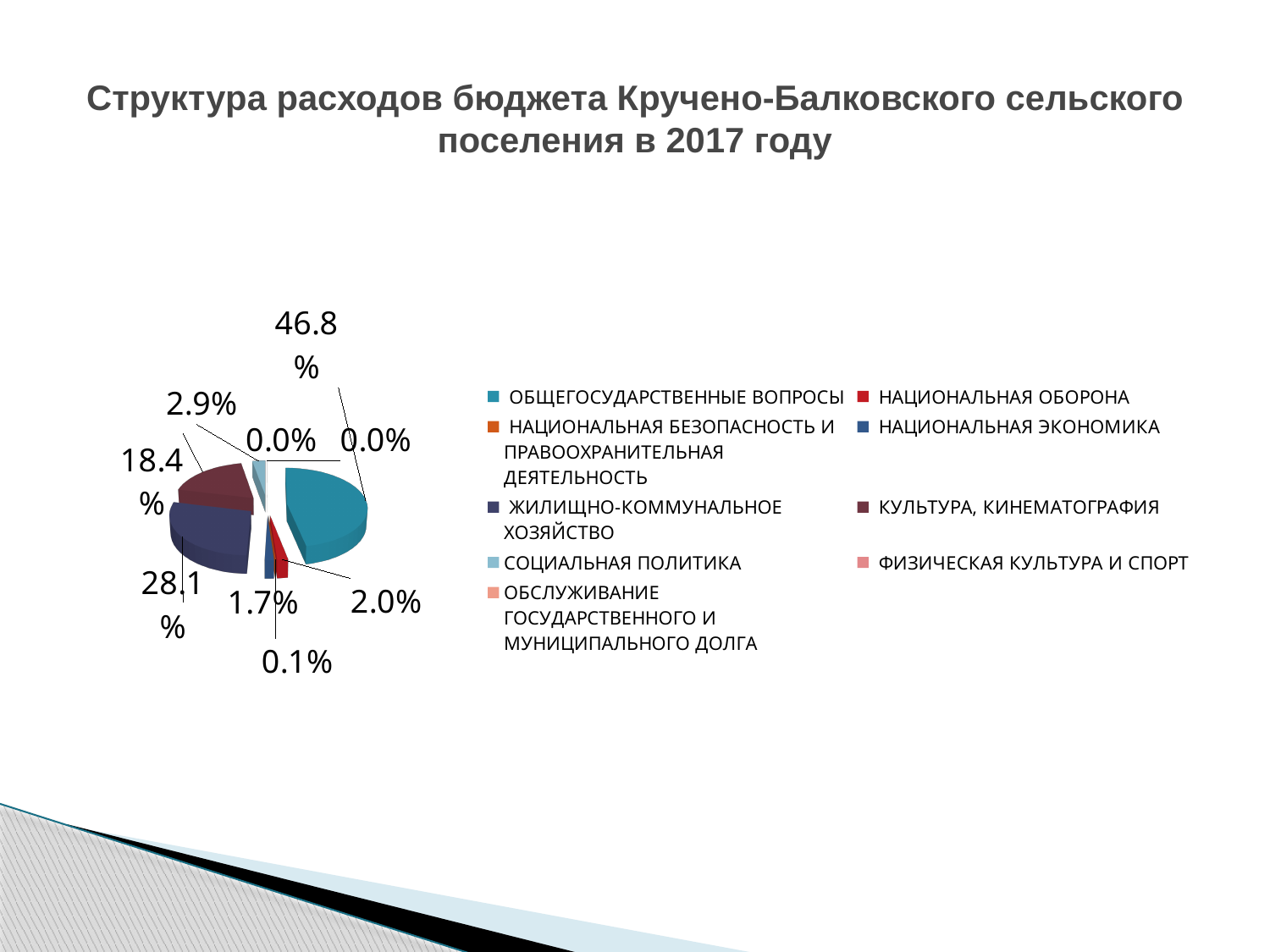
What share of the budget expenditures does ОБЩЕГОСУДАРСТВЕННЫЕ ВОПРОСЫ account for? 46.8% Which category has the largest share of the budget expenditures? ОБЩЕГОСУДАРСТВЕННЫЕ ВОПРОСЫ What colour is the slice for ОБЩЕГОСУДАРСТВЕННЫЕ ВОПРОСЫ in the pie chart? teal What share of the budget expenditures does ЖИЛИЩНО-КОММУНАЛЬНОЕ ХОЗЯЙСТВО account for? 28.1% How many categories does the legend of the pie chart list? 9 What share of the budget expenditures does СОЦИАЛЬНАЯ ПОЛИТИКА account for? 2.9% What is the largest percentage shown on the pie chart? 46.8% What kind of chart is shown on the slide? pie chart Which is larger: the share for ЖИЛИЩНО-КОММУНАЛЬНОЕ ХОЗЯЙСТВО or for КУЛЬТУРА, КИНЕМАТОГРАФИЯ? ЖИЛИЩНО-КОММУНАЛЬНОЕ ХОЗЯЙСТВО What share of the budget expenditures does КУЛЬТУРА, КИНЕМАТОГРАФИЯ account for? 18.4% What is the title of the chart on the slide? Структура расходов бюджета Кручено-Балковского сельского поселения в 2017 году By how many percentage points does the share of ОБЩЕГОСУДАРСТВЕННЫЕ ВОПРОСЫ exceed that of ЖИЛИЩНО-КОММУНАЛЬНОЕ ХОЗЯЙСТВО? 18.7